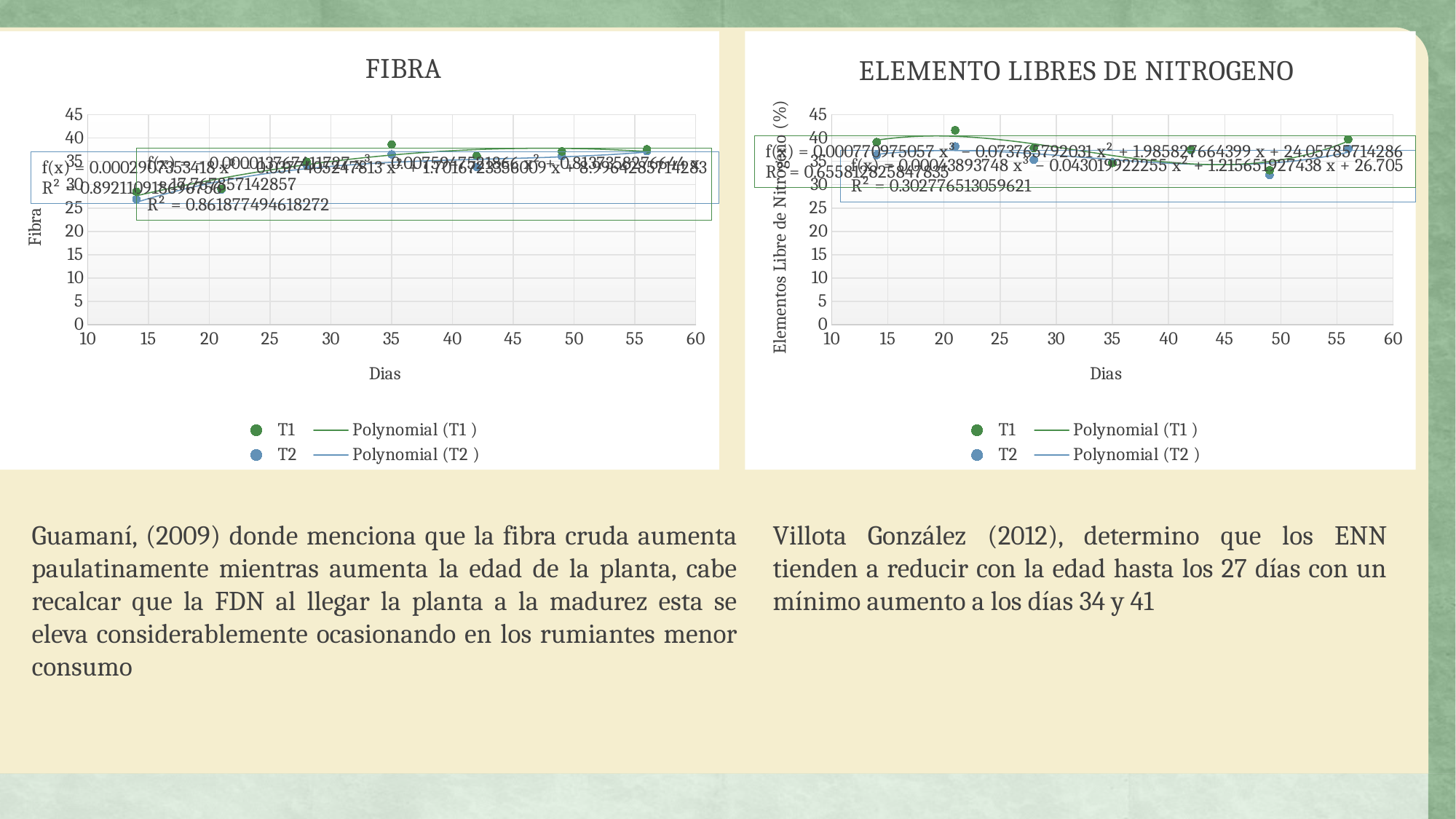
What is the title of the chart on the right? ELEMENTO LIBRES DE NITROGENO In the FIBRA chart, at which number of days is the lowest value plotted? 14 In the FIBRA chart, is the T1 value at 14 days greater or less than 30? less What kind of chart is the FIBRA chart on the left? Scatter chart with polynomial trendlines In the FIBRA chart, how many data points are plotted for series T1? 7 How many entries does the legend of the FIBRA chart list? 4 In the ELEMENTO LIBRES DE NITROGENO chart, is the T1 value at 21 days greater or less than 40? greater In the ELEMENTO LIBRES DE NITROGENO chart, at which number of days is the lowest value plotted? 49 What is the x-axis label of the FIBRA chart? Dias In the FIBRA chart, is the T1 value at 35 days greater or less than 35? greater In the FIBRA chart, do the values generally rise or fall as the days increase? rise